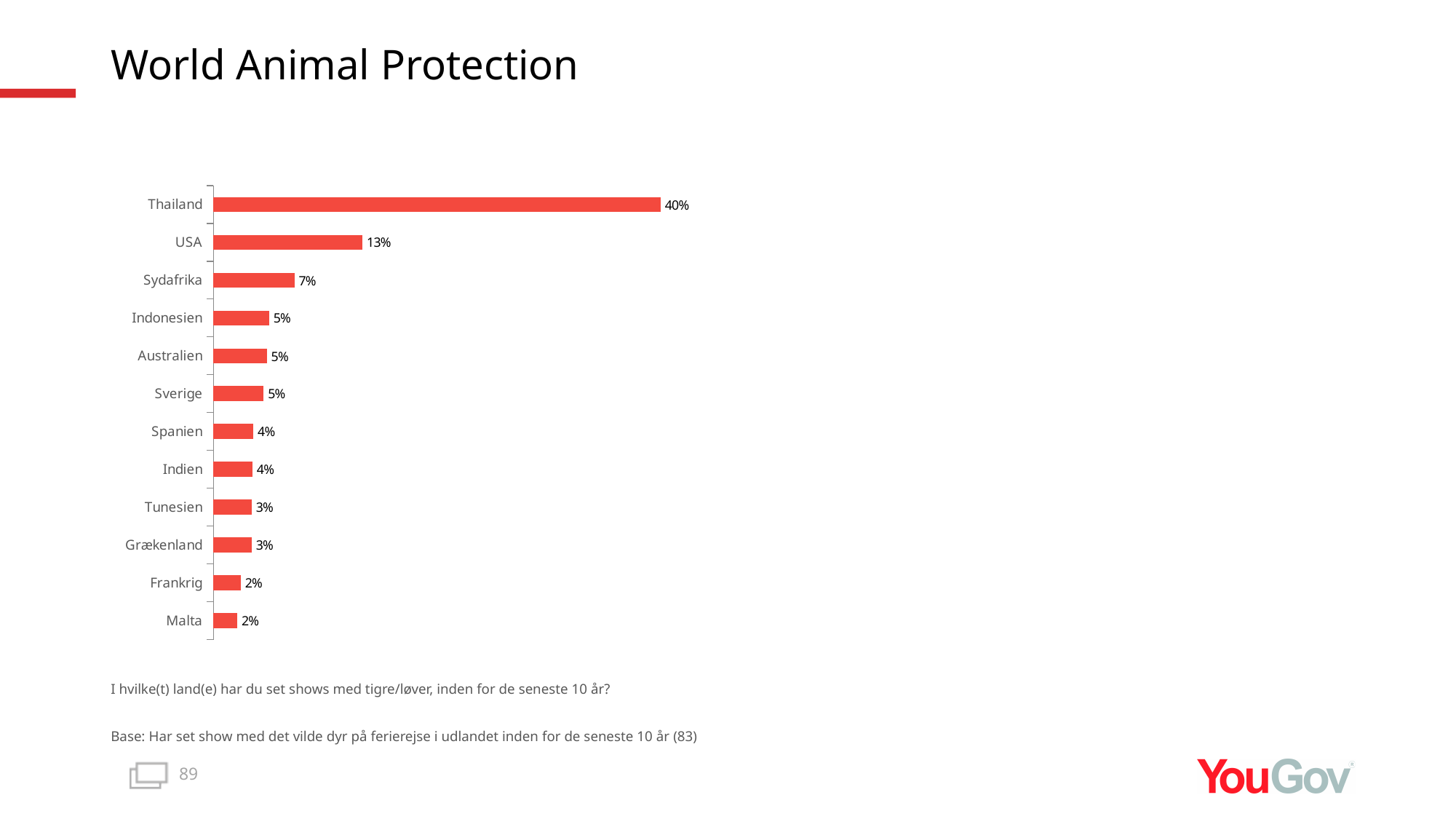
Which is larger, the value for USA or the value for Sydafrika? USA What is the value for Sydafrika? 7% Which country has the highest value? Thailand What is the value for Tunesien? 3% Which is larger, the value for Indonesien or the value for Spanien? Indonesien What is the title of the slide? World Animal Protection What is the value for Thailand? 40% How many countries are shown in the chart? 12 What kind of chart is shown on the slide? Bar chart What is the value for USA? 13% What is the difference between the values for Thailand and USA? 27% What is the difference between the values for USA and Sydafrika? 6%